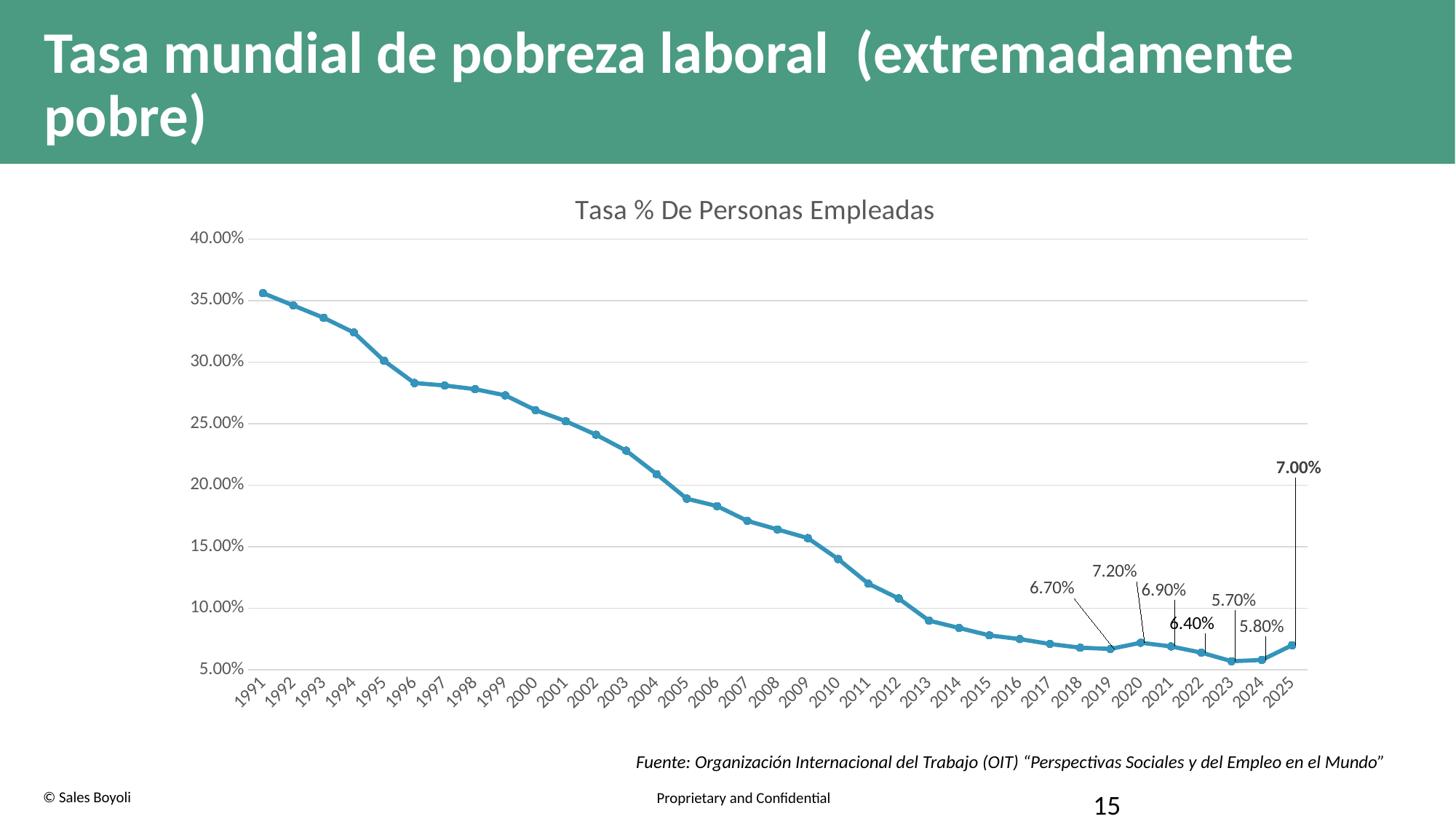
What is the value for 2023? 5.70% What is the value for 2019? 6.70% Which is larger, the value for 2021 or the value for 2022? 2021 How many years are plotted on the x axis? 35 Is the value for 1995 greater or less than 25.00%? greater What kind of chart is shown on the slide? line chart What is the value for 2025? 7.00% What is the difference between the values for 2020 and 2023? 1.50% Which year has the highest value? 1991 Do the values generally rise or fall from 1991 to 2025? fall What is the difference between the values for 2025 and 2024? 1.20% What is the value for 2020? 7.20%